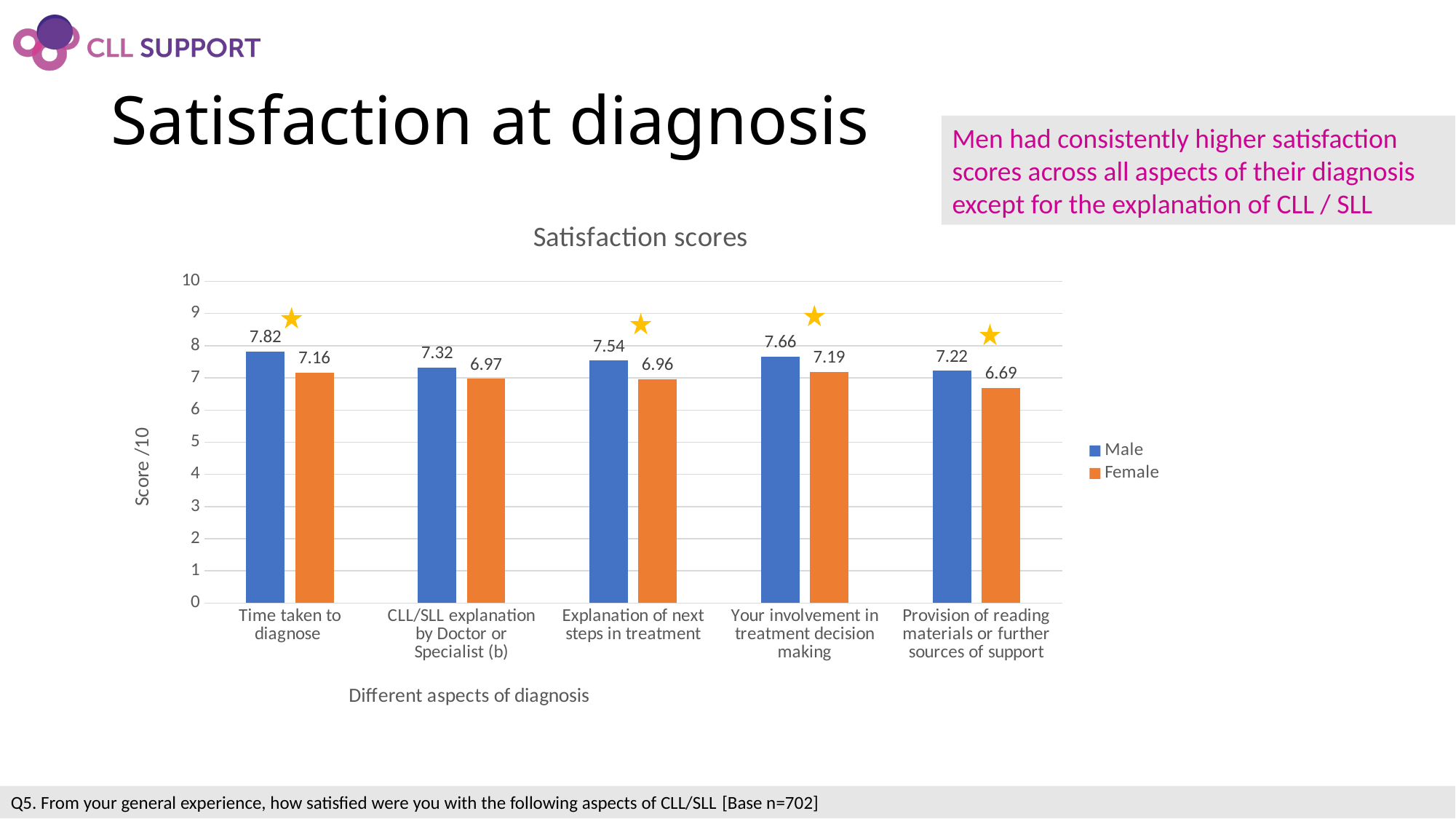
What is the Male satisfaction score for 'Time taken to diagnose'? 7.82 How many series does the legend list? 2 What is the Female satisfaction score for 'Provision of reading materials or further sources of support'? 6.69 What is the Female score for 'Your involvement in treatment decision making'? 7.19 What is the difference between the Male and Female scores for 'Explanation of next steps in treatment'? 0.58 What kind of chart is shown on the slide? Bar chart Which aspect of diagnosis has the lowest Female satisfaction score? Provision of reading materials or further sources of support What is the title of the chart? Satisfaction scores What is the difference between the Male and Female scores for 'Time taken to diagnose'? 0.66 Which is larger, the Male score for 'CLL/SLL explanation by Doctor or Specialist (b)' or the Female score for 'Time taken to diagnose'? Male score for CLL/SLL explanation by Doctor or Specialist (b) Which aspect of diagnosis has the highest Male satisfaction score? Time taken to diagnose How many aspects of diagnosis are shown on the x axis? 5